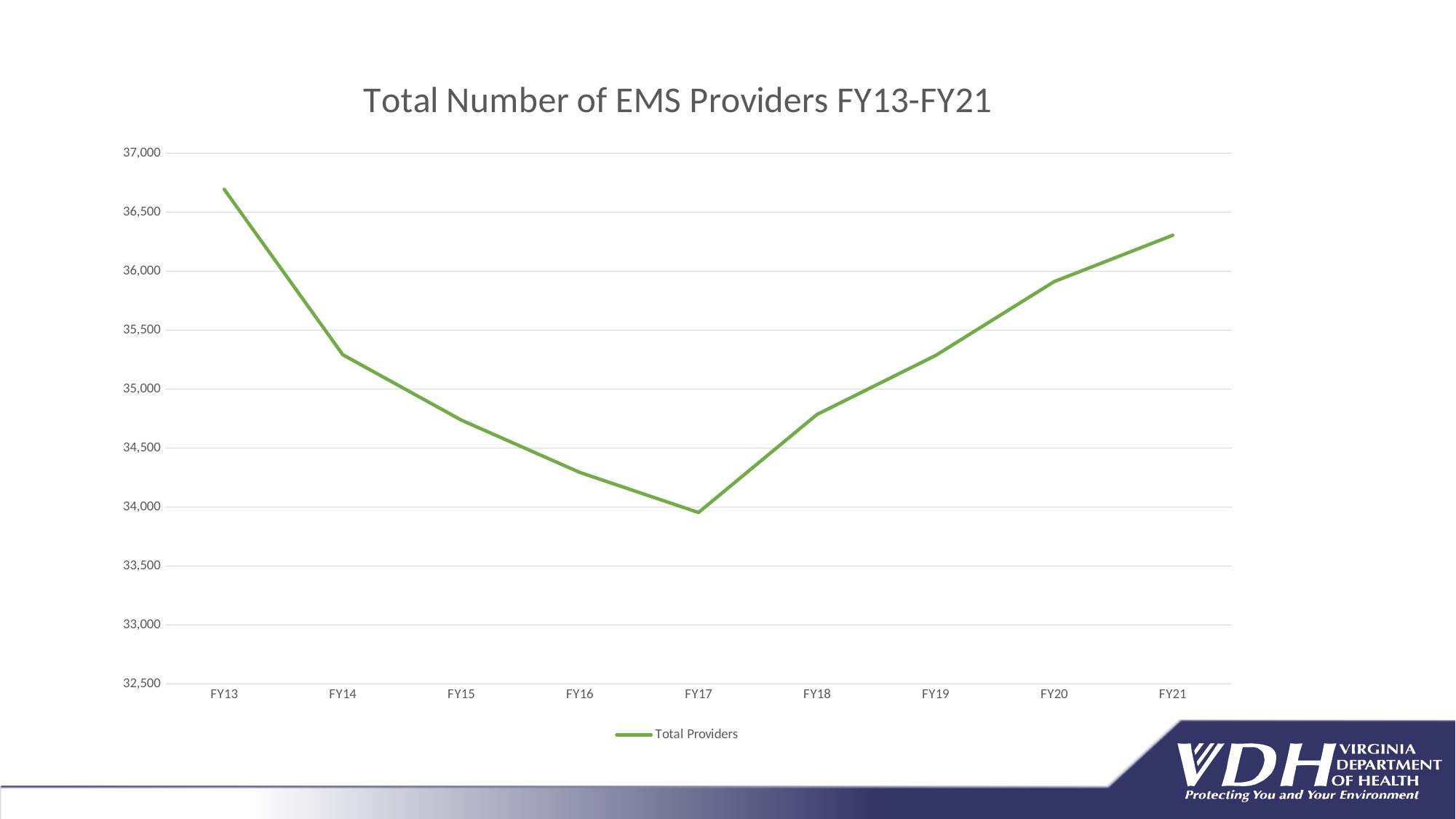
Is the value for FY13 greater or less than 36,500? greater How many fiscal years are plotted on the x axis? 9 Which fiscal year has the highest number of total providers? FY13 Is the value for FY17 greater or less than 34,500? less Do the values rise or fall from FY17 to FY21? rise What kind of chart is shown on the slide? line chart Which is larger, the value for FY13 or the value for FY21? FY13 Is the value for FY21 greater or less than 36,000? greater Which fiscal year has the lowest number of total providers? FY17 What is the title of the chart? Total Number of EMS Providers FY13-FY21 How many series does the legend list? 1